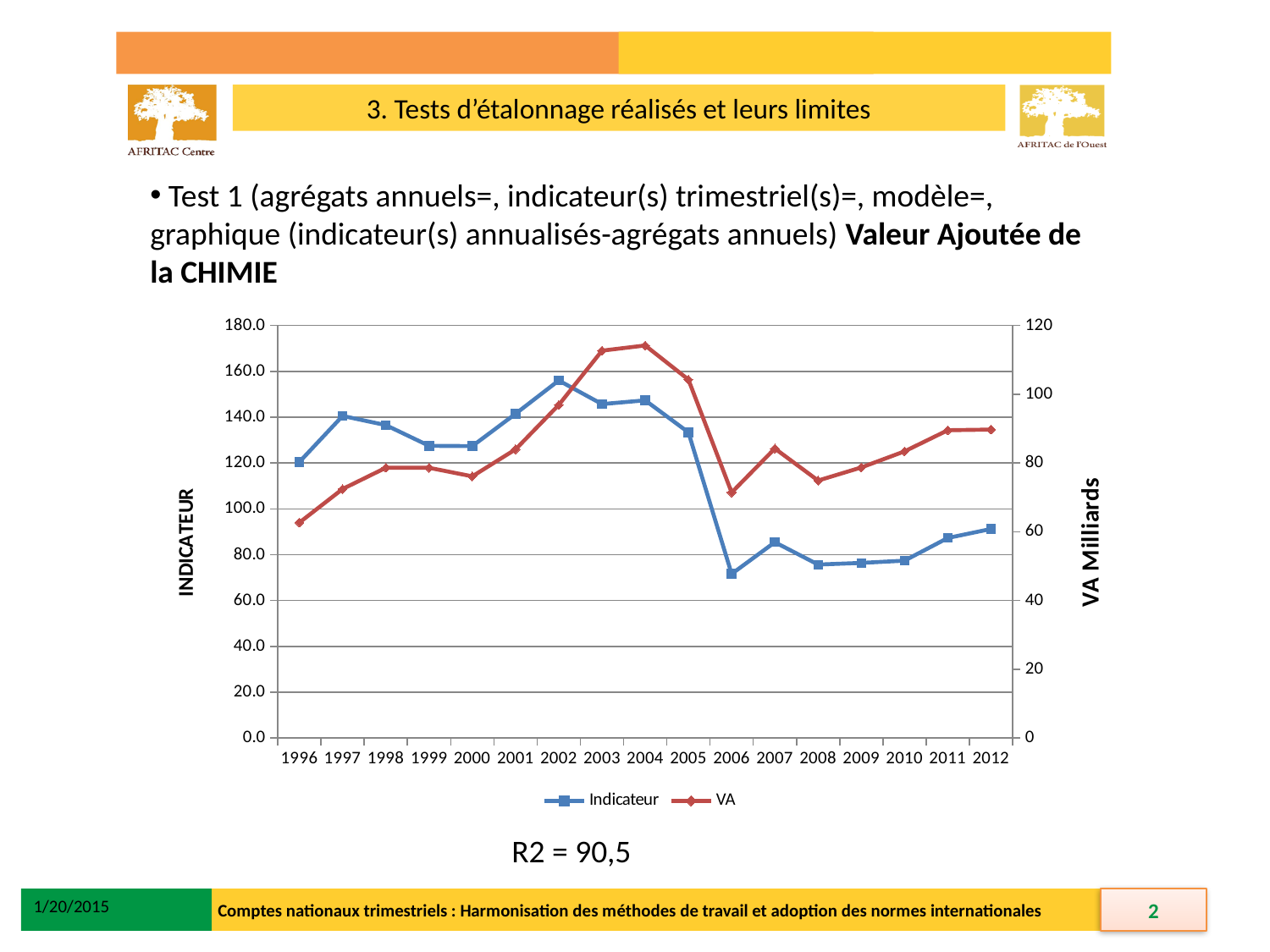
Is the Indicateur value for 2002 greater or less than 140? greater In which year does the Indicateur series reach its highest value? 2002 What kind of chart is shown on the slide? Line chart In which year is the VA series at its lowest? 1996 Is the VA value for 2003 greater or less than 100? greater How many series does the chart legend list? 2 How many years are plotted along the x axis of the chart? 17 Which year has the larger Indicateur value, 1997 or 2012? 1997 What is the title of the right-hand vertical axis of the chart? VA Milliards Is the Indicateur value for 2006 greater or less than 80? less Does the Indicateur series rise or fall between 2005 and 2006? Fall In which year does the Indicateur series reach its lowest value? 2006